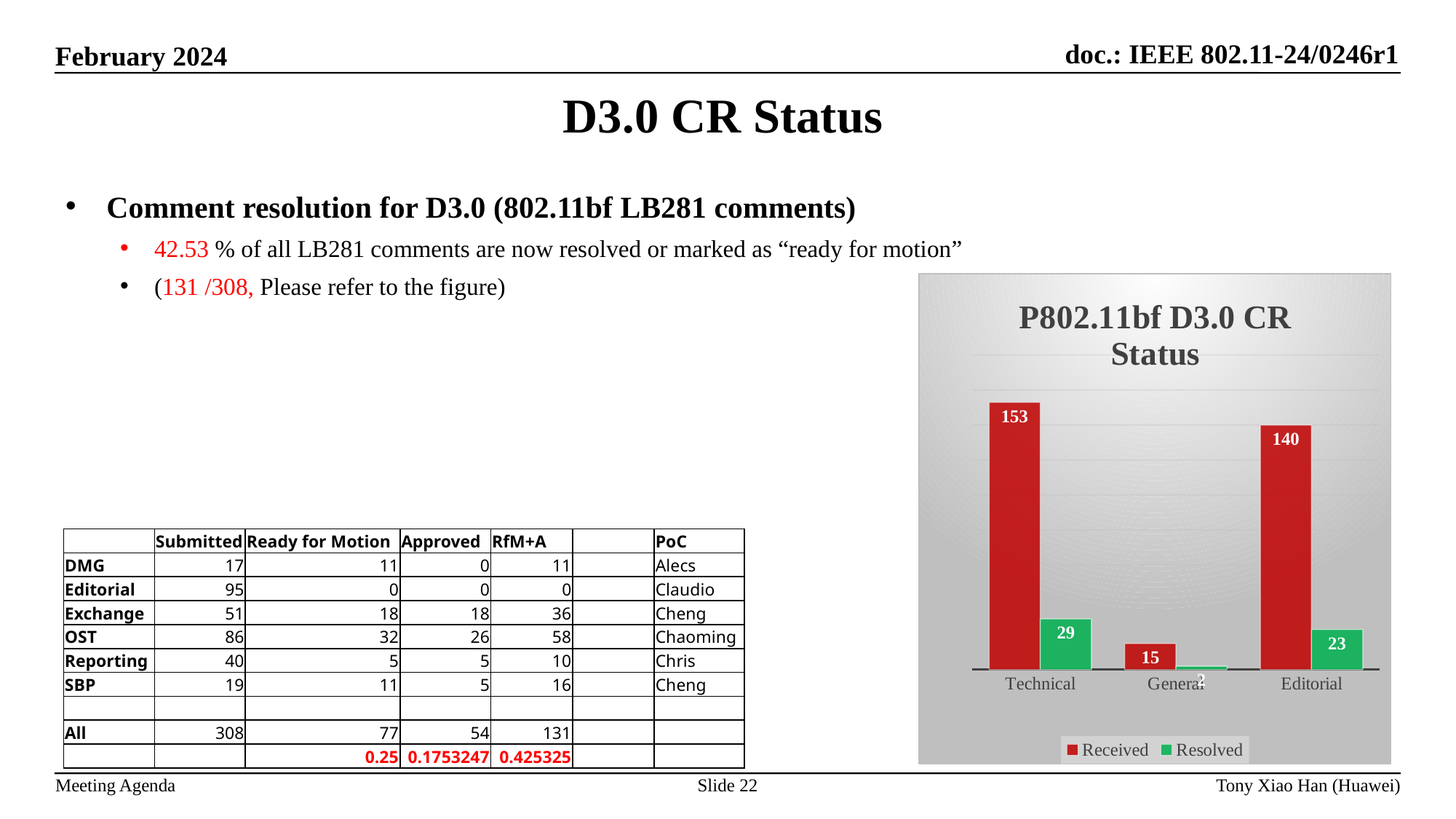
How many series does the chart legend list? 2 Which category has the lowest Received value? General What is the difference between the Received values for Technical and Editorial? 13 What is the Resolved value for Technical? 29 What is the Received value for Technical? 153 What is the Resolved value for Editorial? 23 What is the Received value for Editorial? 140 Which category has the highest Received value? Technical How many categories are shown on the x axis of the chart? 3 What is the chart's title? P802.11bf D3.0 CR Status What is the Received value for General? 15 What type of chart is shown on the slide? bar chart